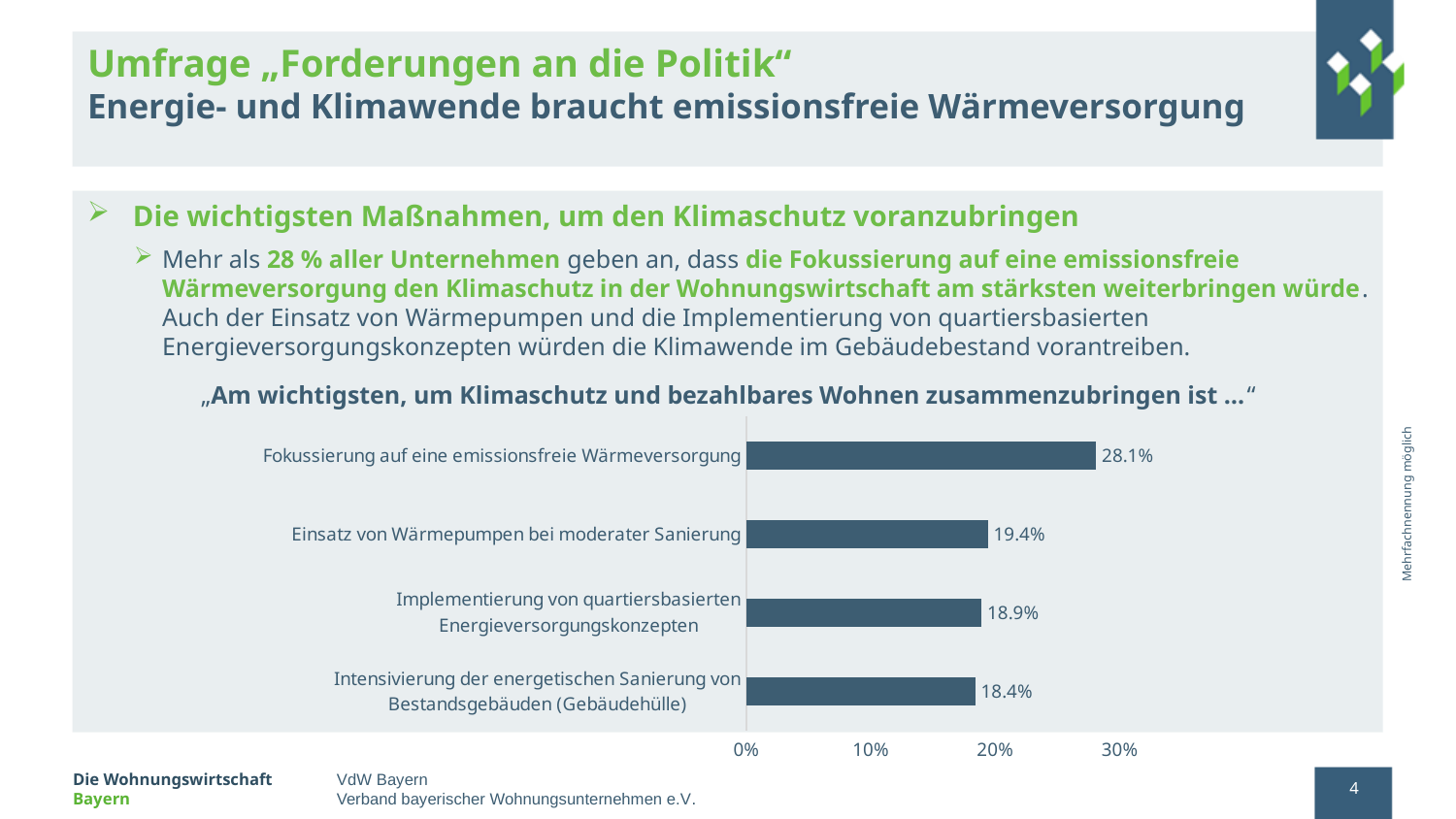
Which category has the lowest value? Intensivierung der energetischen Sanierung von Bestandsgebäuden (Gebäudehülle) What is the value for "Intensivierung der energetischen Sanierung von Bestandsgebäuden (Gebäudehülle)"? 18.4% What is the value for "Einsatz von Wärmepumpen bei moderater Sanierung"? 19.4% What kind of chart is shown on the slide? bar chart Which category has the highest value? Fokussierung auf eine emissionsfreie Wärmeversorgung Is the value for "Fokussierung auf eine emissionsfreie Wärmeversorgung" greater or less than 20%? greater What is the value for "Implementierung von quartiersbasierten Energieversorgungskonzepten"? 18.9% Which is larger: the value for "Einsatz von Wärmepumpen bei moderater Sanierung" or for "Intensivierung der energetischen Sanierung von Bestandsgebäuden (Gebäudehülle)"? Einsatz von Wärmepumpen bei moderater Sanierung What is the value for "Fokussierung auf eine emissionsfreie Wärmeversorgung"? 28.1% What is the difference between the values for "Fokussierung auf eine emissionsfreie Wärmeversorgung" and "Einsatz von Wärmepumpen bei moderater Sanierung"? 8.7% How many categories are shown in the chart? 4 What is the title of the chart? „Am wichtigsten, um Klimaschutz und bezahlbares Wohnen zusammenzubringen ist …“